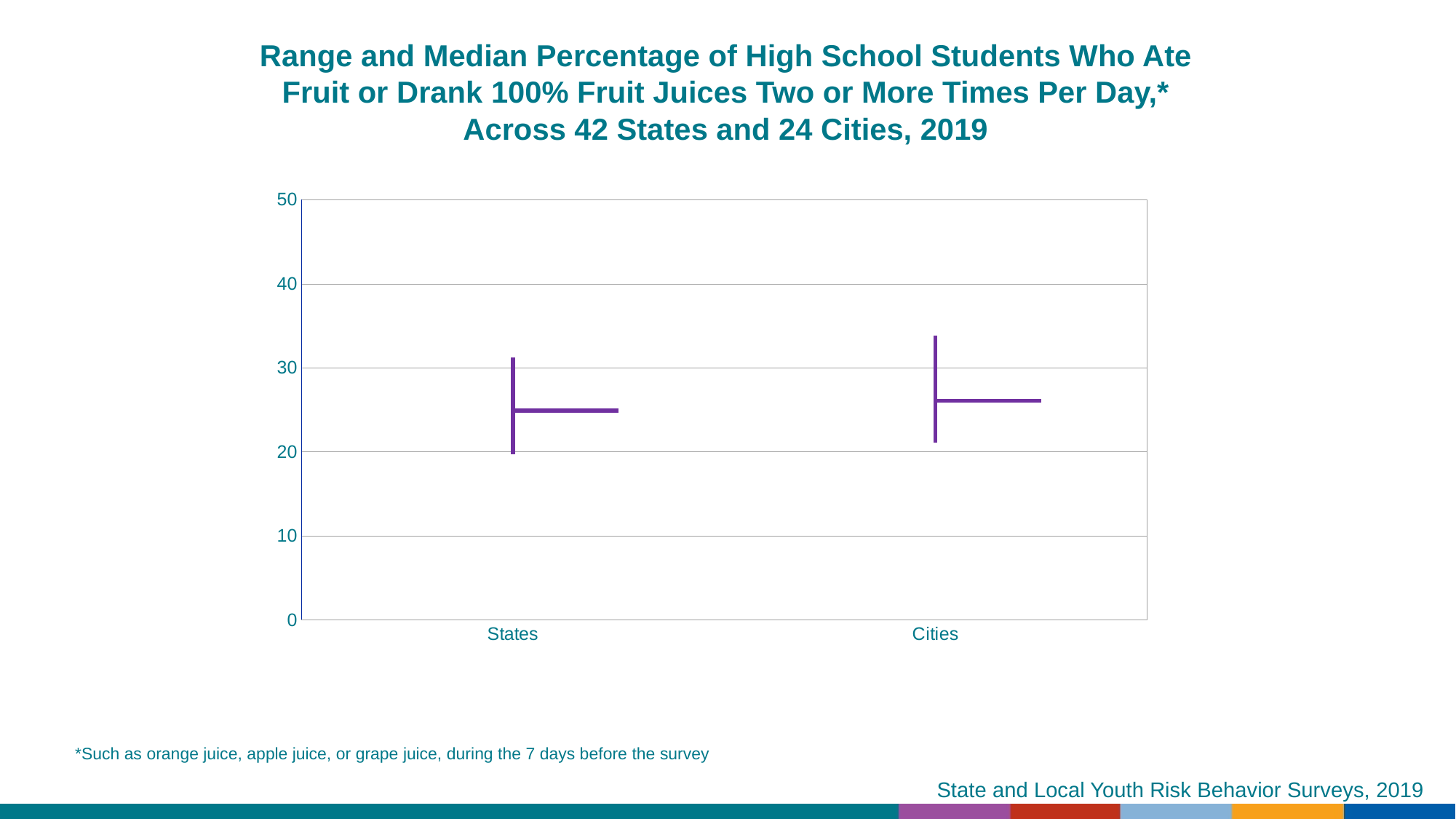
According to the title, how many states and cities are included in the chart? 42 states and 24 cities What are the two categories shown on the x axis? States and Cities What is the highest value shown on the y axis? 50 Is the top of the range for Cities greater or less than 30? greater What does the chart show for each category, according to its title? Range and median percentage Is the median value for States greater or less than 20? greater Is the bottom of the range for Cities greater or less than 20? greater How many categories are shown on the x axis of the chart? 2 Which category has the higher top of its range, States or Cities? Cities